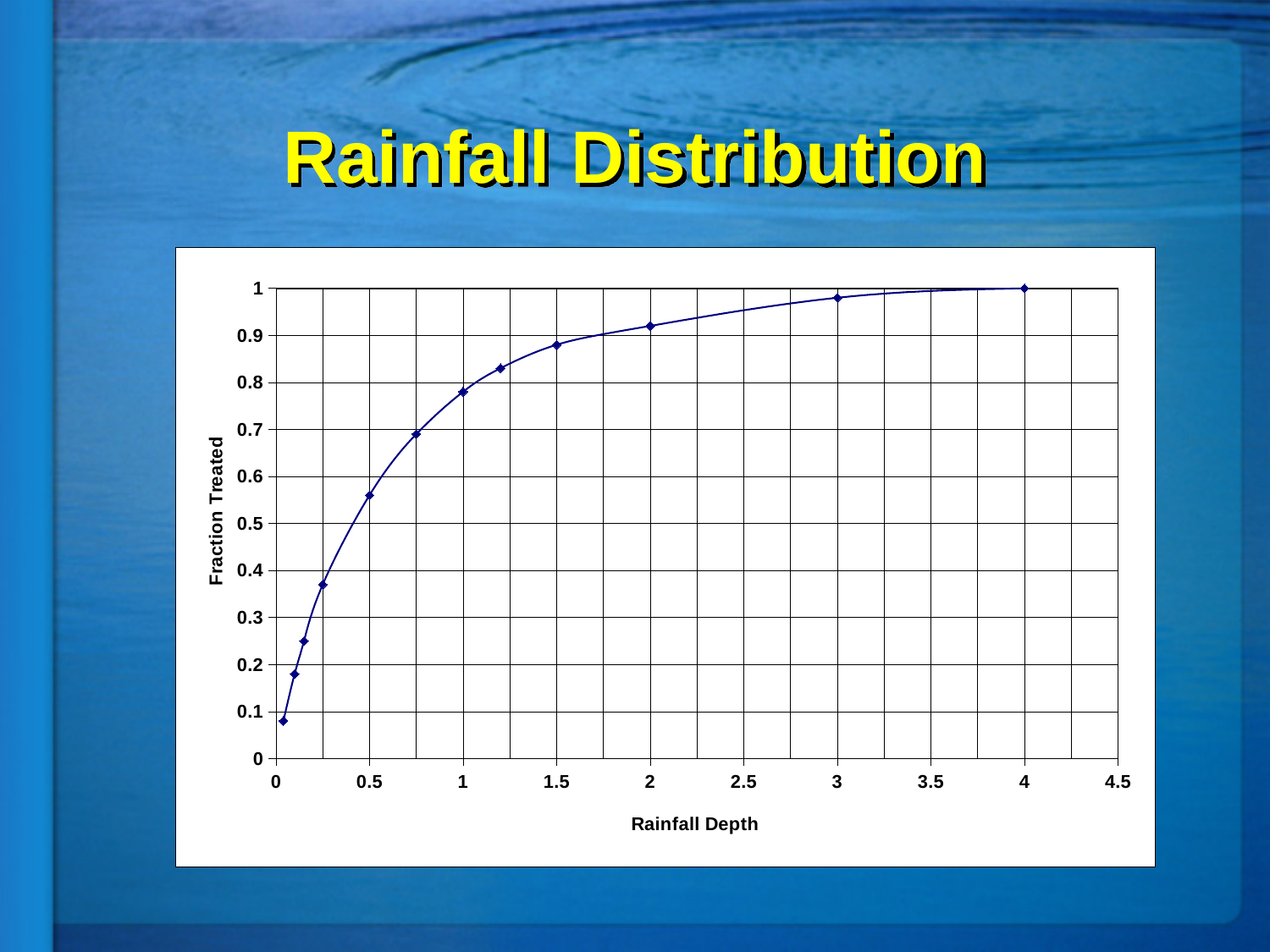
Is the Fraction Treated at a Rainfall Depth of 1 greater or less than 0.8? less How many data points are plotted on the line? 12 What is the Fraction Treated at a Rainfall Depth of 4? 1 At which Rainfall Depth is the Fraction Treated highest? 4 Does the Fraction Treated rise or fall as Rainfall Depth increases? rise Is the Fraction Treated at a Rainfall Depth of 2 greater or less than 0.9? greater What is the label of the vertical axis? Fraction Treated What kind of chart is shown on the slide? line chart What is the title of the chart? Rainfall Distribution Is the Fraction Treated at a Rainfall Depth of 1.5 greater or less than 0.9? less Which has the larger Fraction Treated, a Rainfall Depth of 1 or a Rainfall Depth of 2? 2